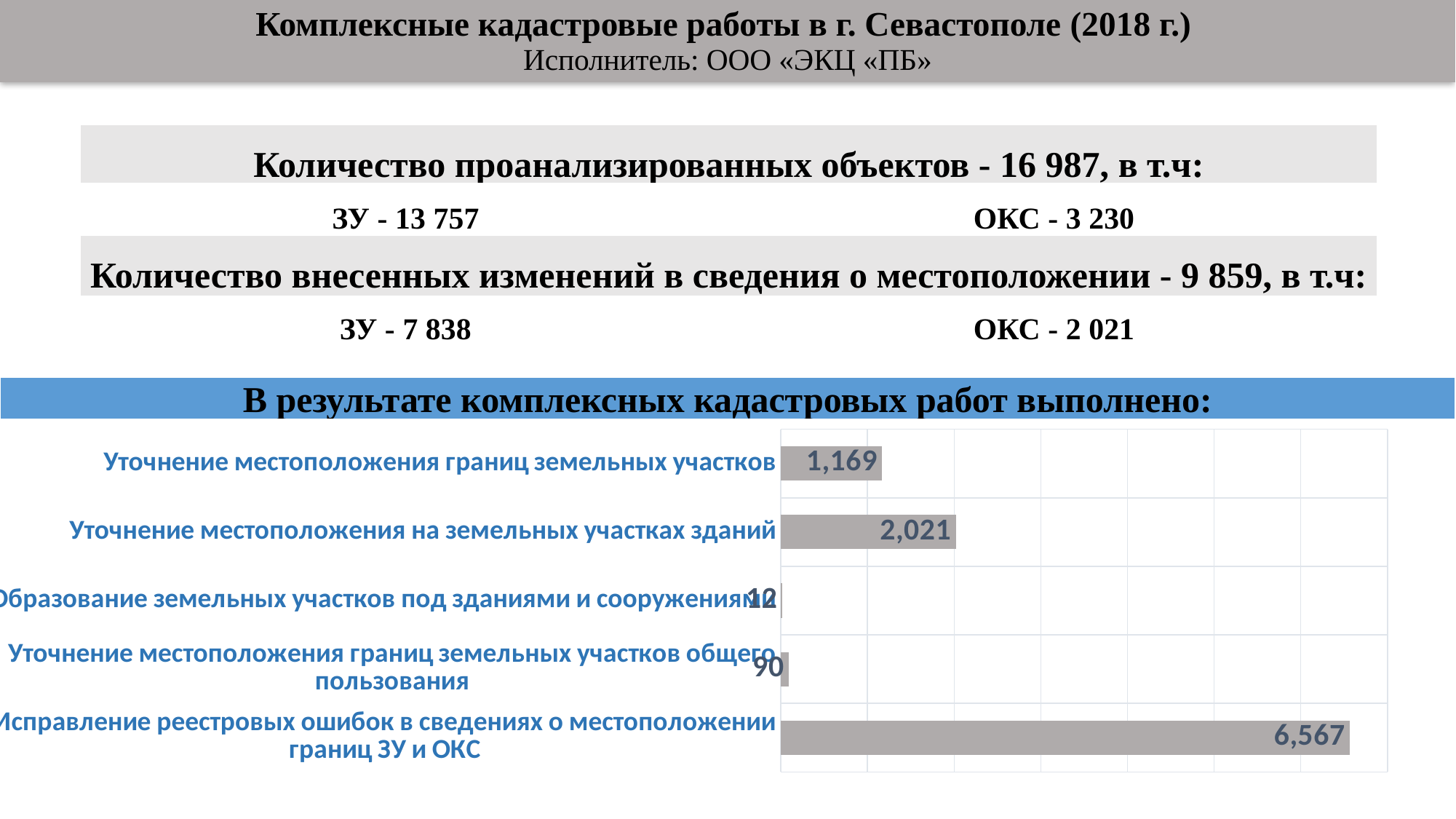
What is the value for «Уточнение местоположения границ земельных участков общего пользования» in the bar chart? 90 What is the value for «Исправление реестровых ошибок в сведениях о местоположении границ ЗУ и ОКС» in the bar chart? 6,567 Which category has the lowest value in the bar chart? Образование земельных участков под зданиями и сооружениями What is the difference between the value for «Уточнение местоположения на земельных участках зданий» and the value for «Уточнение местоположения границ земельных участков»? 852 Which is larger: the value for «Уточнение местоположения границ земельных участков» or the value for «Уточнение местоположения на земельных участках зданий»? Уточнение местоположения на земельных участках зданий What is the value for «Уточнение местоположения границ земельных участков» in the bar chart? 1,169 What type of chart is shown on the slide? Bar chart What is the difference between the value for «Исправление реестровых ошибок в сведениях о местоположении границ ЗУ и ОКС» and the value for «Уточнение местоположения на земельных участках зданий»? 4,546 What colour are the bars in the chart? Grey What is the value for «Уточнение местоположения на земельных участках зданий» in the bar chart? 2,021 How many categories are shown in the bar chart? 5 Which category has the highest value in the bar chart? Исправление реестровых ошибок в сведениях о местоположении границ ЗУ и ОКС